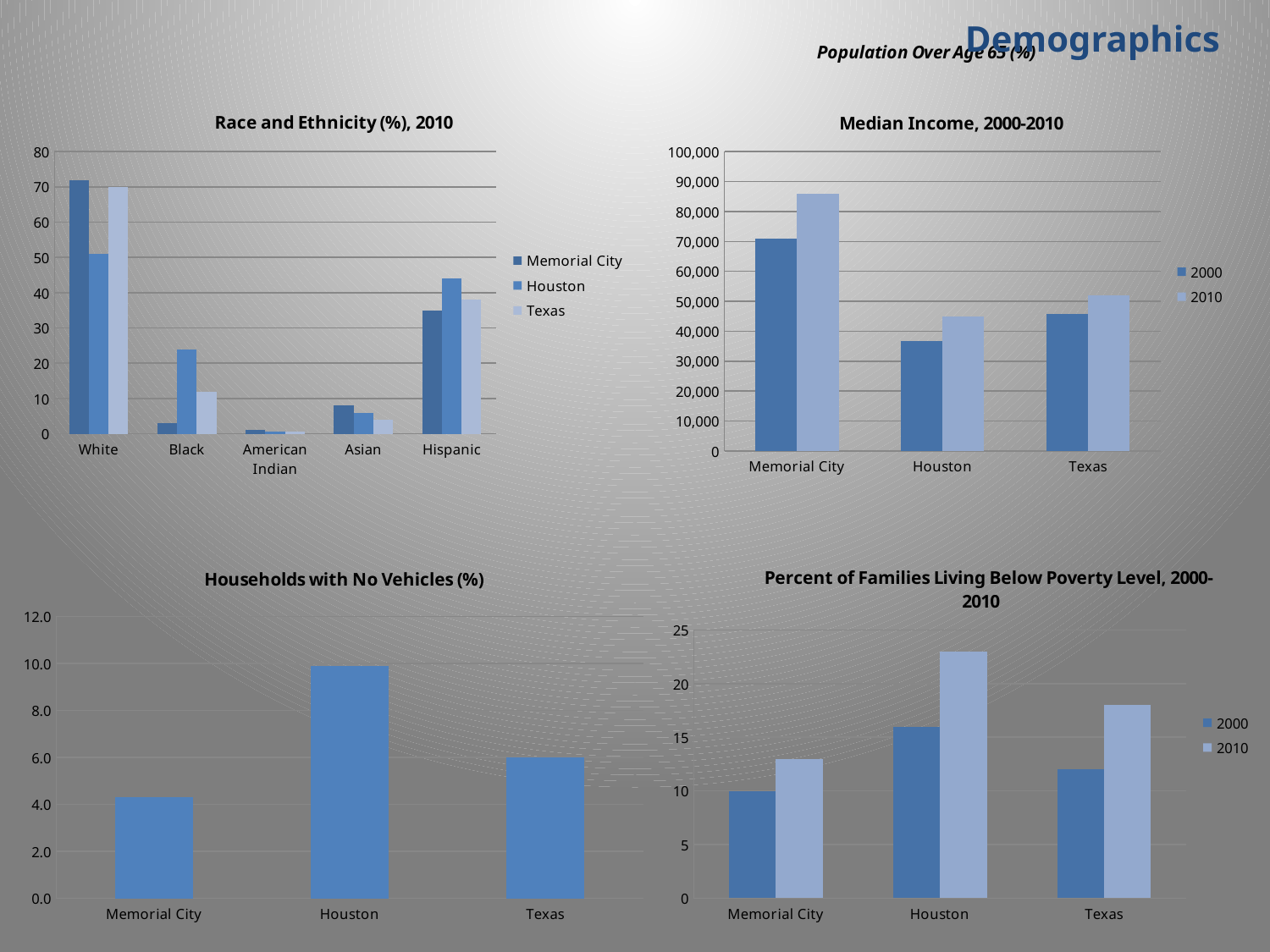
What kind of chart is Households with No Vehicles (%)? bar chart In the Households with No Vehicles (%) chart, which area has the highest value? Houston In the Race and Ethnicity (%), 2010 chart, which series has the highest value for Black? Houston In the Median Income, 2000-2010 chart, is the 2000 value for Houston greater or less than 40,000? less In the Race and Ethnicity (%), 2010 chart, how many series does the legend list? 3 In the Race and Ethnicity (%), 2010 chart, how many race/ethnicity categories are shown on the x axis? 5 In the Median Income, 2000-2010 chart, which is larger for Texas: the 2000 value or the 2010 value? 2010 In the Race and Ethnicity (%), 2010 chart, is the Houston value for White greater or less than 60? less In the Median Income, 2000-2010 chart, which area has the highest median income in 2010? Memorial City In the Percent of Families Living Below Poverty Level, 2000-2010 chart, which area has the lowest value in 2000? Memorial City In the Race and Ethnicity (%), 2010 chart, which category has the lowest values across all three series? American Indian In the Percent of Families Living Below Poverty Level, 2000-2010 chart, is the 2010 value for Houston greater or less than 20? greater